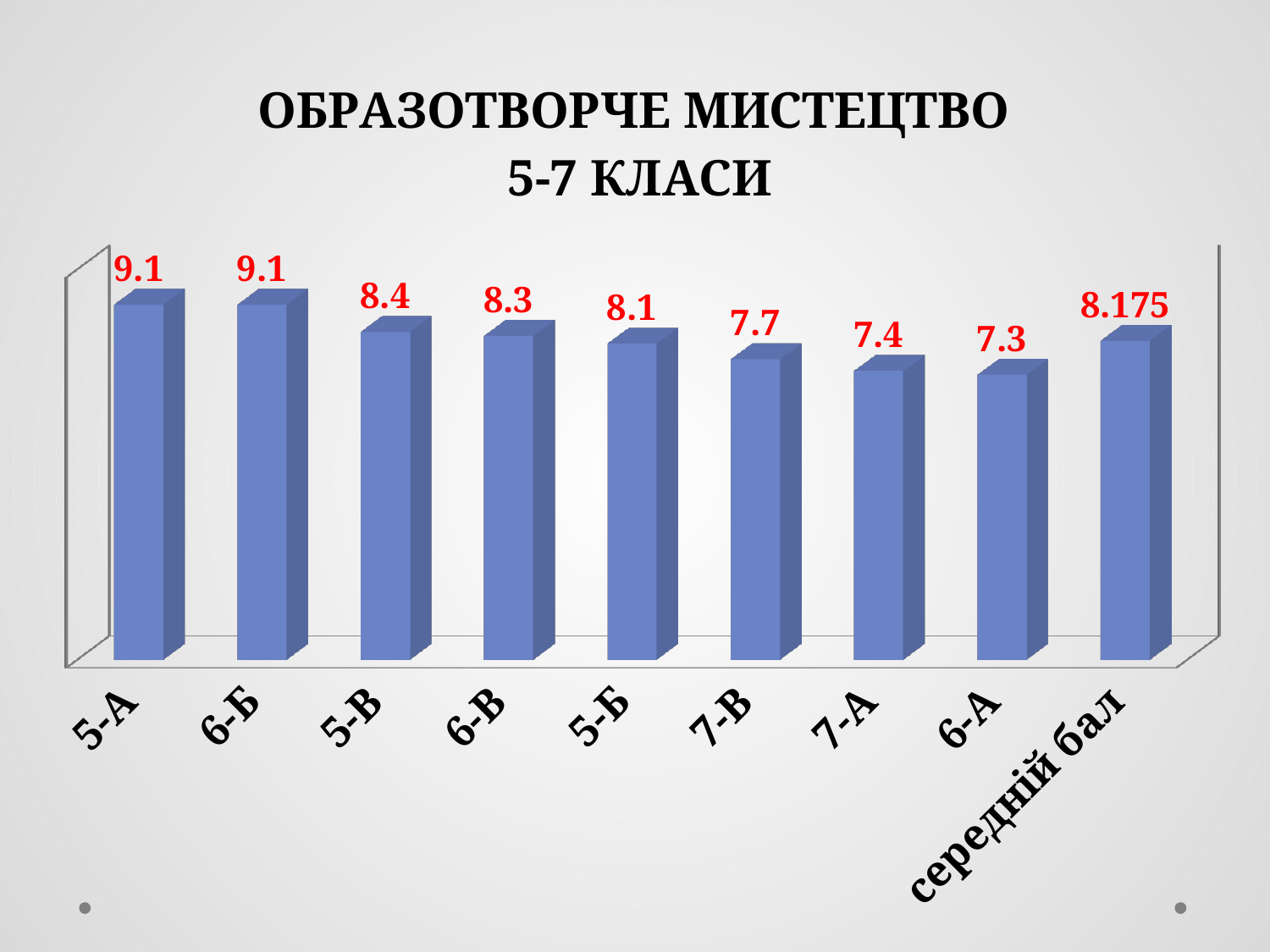
What kind of chart is shown on the slide? bar chart What is the value for 5-А? 9.1 Which category has the lowest value? 6-А What is the value for 6-А? 7.3 What is the difference between the values for 5-А and 6-А? 1.8 What is the value for 7-В? 7.7 What is the title of the chart? ОБРАЗОТВОРЧЕ МИСТЕЦТВО 5-7 КЛАСИ What is the value shown for середній бал? 8.175 What is the difference between the values for 5-В and 6-В? 0.1 Which is larger, the value for 5-Б or the value for 7-А? 5-Б How many categories are shown on the x axis? 9 Which is larger, the value for 7-В or the value for середній бал? середній бал